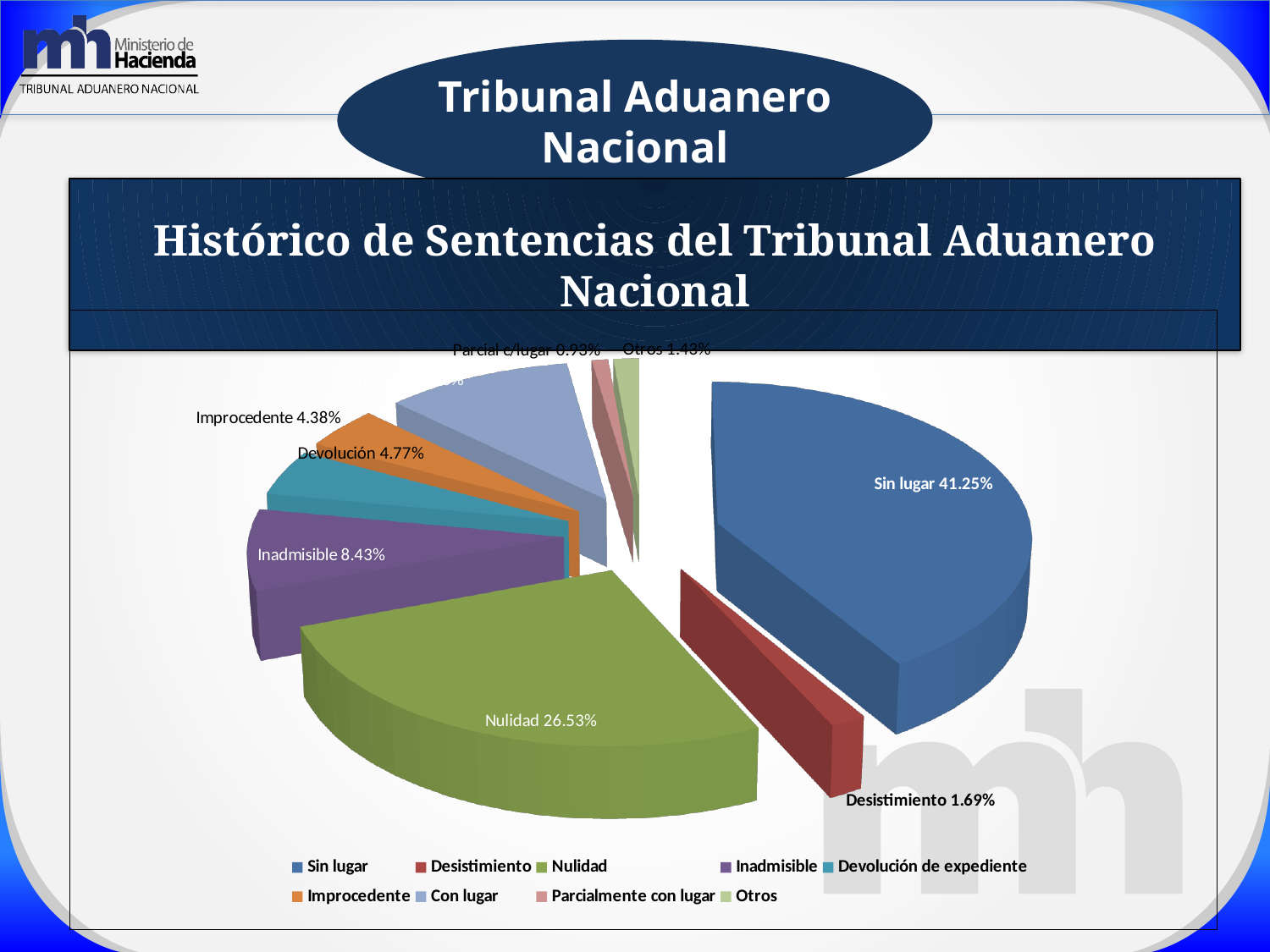
What percentage is shown for 'Nulidad'? 26.53% What percentage is shown for 'Improcedente'? 4.38% What percentage is shown for 'Devolución'? 4.77% How many categories does the legend list? 9 What percentage is shown for 'Inadmisible'? 8.43% Which category has the largest share of the pie? Sin lugar Which is larger, the share for 'Nulidad' or for 'Inadmisible'? Nulidad What percentage is shown for 'Desistimiento'? 1.69% What kind of chart is shown on the slide? pie chart What colour is the 'Sin lugar' slice? blue What is the difference in percentage points between 'Sin lugar' and 'Nulidad'? 14.72 What percentage of sentences is labelled 'Sin lugar'? 41.25%